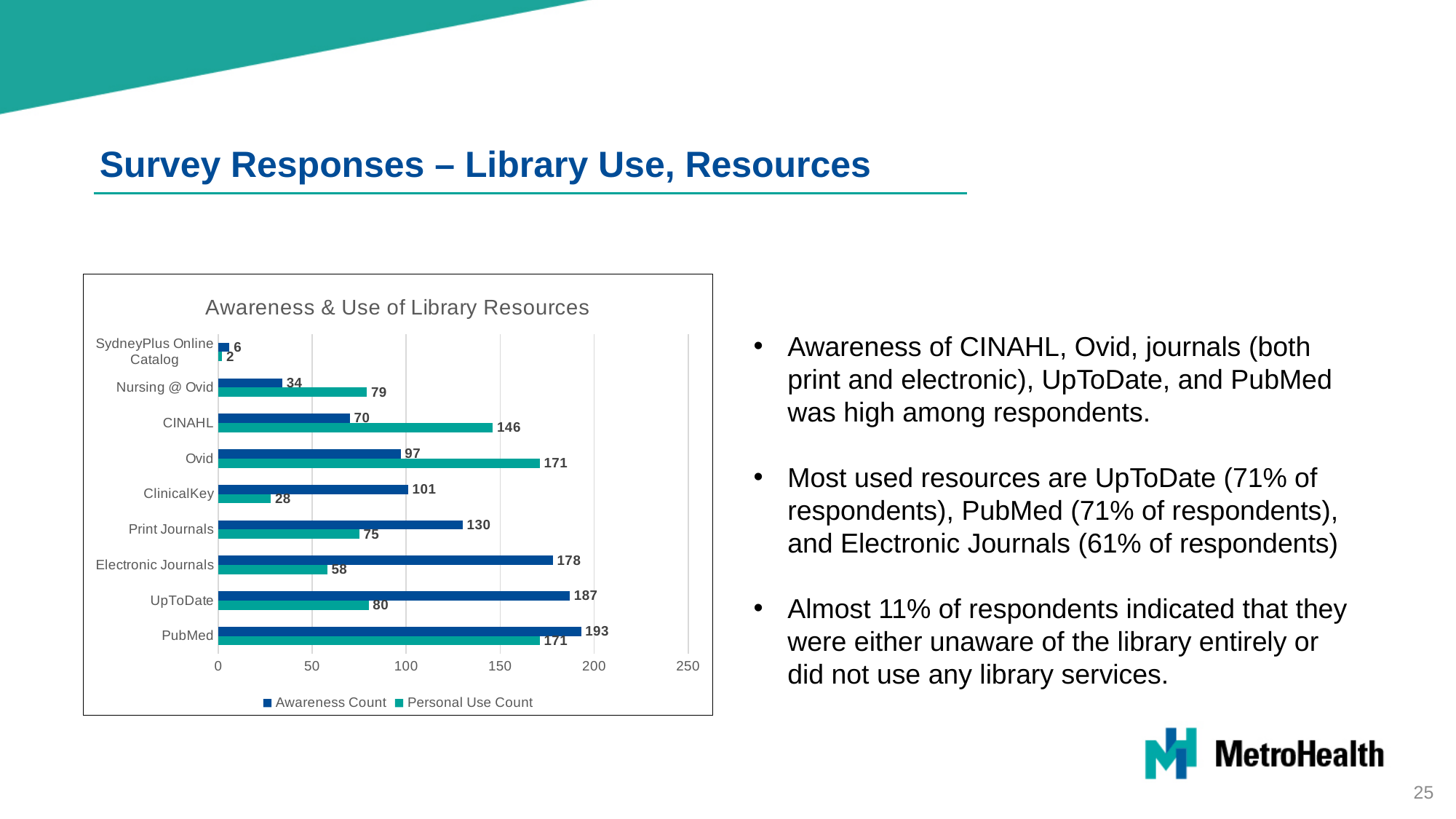
Which resource has the highest Awareness Count? PubMed What is the Personal Use Count for CINAHL? 146 How many resources are listed on the chart? 9 Which is larger for Ovid: the Awareness Count or the Personal Use Count? Personal Use Count Which resource has the lowest Personal Use Count? SydneyPlus Online Catalog What kind of chart is shown on the slide? Bar chart What is the title of the chart? Awareness & Use of Library Resources What is the Personal Use Count for ClinicalKey? 28 How many series does the legend list? 2 What is the difference between the Awareness Count and the Personal Use Count for Electronic Journals? 120 What is the difference between the Awareness Count for UpToDate and the Awareness Count for Print Journals? 57 What is the Awareness Count for PubMed? 193